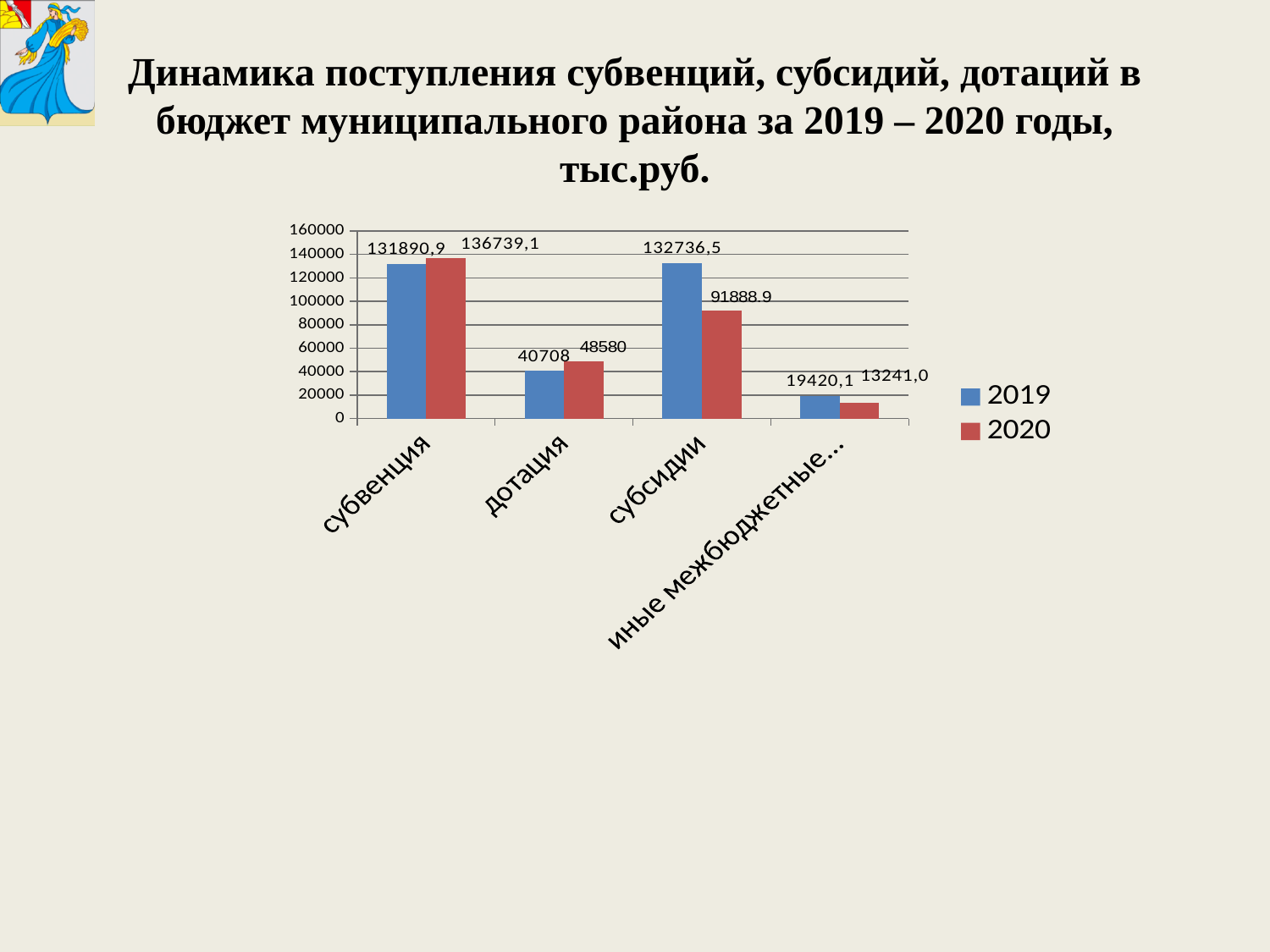
Which category has the lowest value in the 2019 series? иные межбюджетные... For субвенция, which year has the larger value, 2019 or 2020? 2020 How many categories are shown on the x axis? 4 What is the value for субсидии in 2020? 91888,9 What is the value for субвенция in 2019? 131890,9 How many series does the legend list? 2 What is the value for дотация in 2020? 48580 What is the difference between the 2019 and 2020 values for субсидии? 40847,6 Which category has the highest value in the 2020 series? субвенция What kind of chart is shown on the slide? bar chart Which colour represents the 2019 series in the legend? blue What is the difference between the 2020 and 2019 values for дотация? 7872